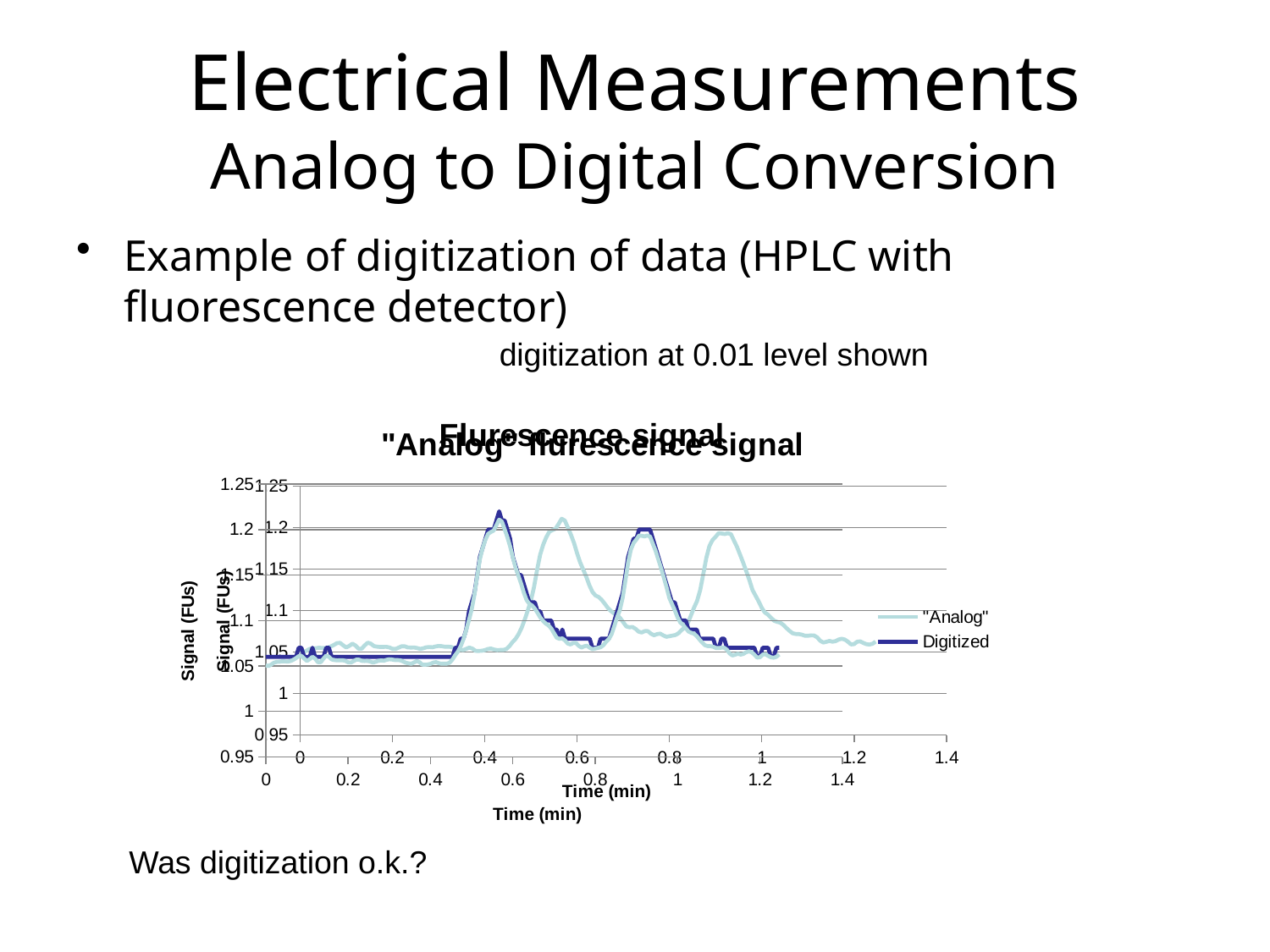
What is the label on the x axis of the chart? Time (min) How many series does the legend list? 2 How many peaks does the Digitized line show? 2 What are the two series named in the legend? "Analog" and Digitized Is the peak value of the Digitized line greater or less than 1.1? greater Is the baseline value of the "Analog" line at time 0 greater or less than 1.1? less What kind of chart is shown on the slide? line chart Which series is drawn with the darker, thicker line? Digitized